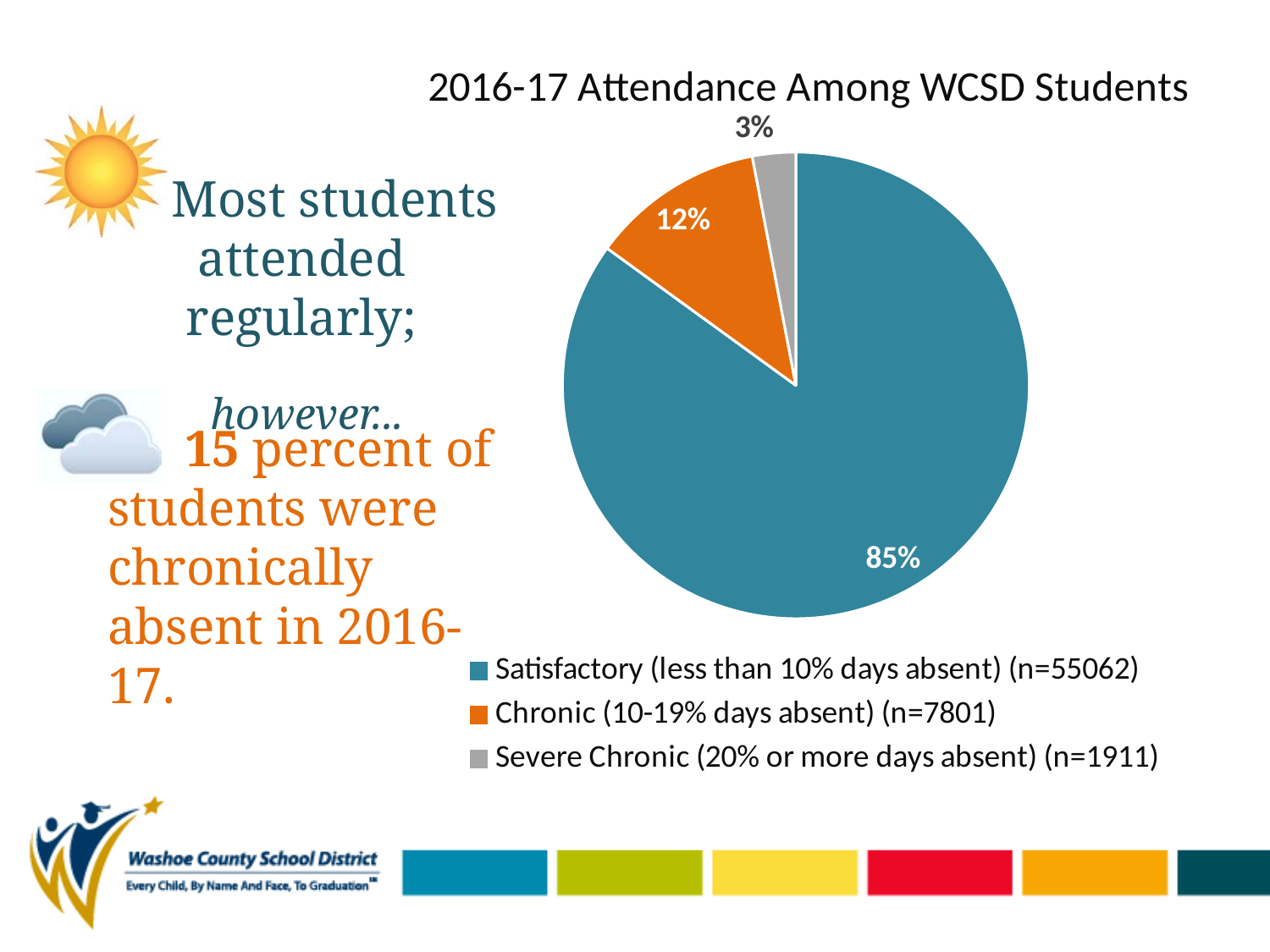
What percentage of students had Satisfactory attendance (less than 10% days absent)? 85% What percentage of students were Severe Chronic (20% or more days absent)? 3% What is the difference in percentage points between the Chronic and Severe Chronic slices? 9 What is the n value shown in the legend for the Chronic category? 7801 What is the combined percentage of the Chronic and Severe Chronic slices? 15% Which is larger, the Chronic slice or the Severe Chronic slice? Chronic Which category has the largest share of the pie? Satisfactory (less than 10% days absent) How many categories does the pie chart show? 3 What kind of chart is shown on the slide? pie chart What percentage of students were Chronic (10-19% days absent)? 12% Which category has the smallest share of the pie? Severe Chronic (20% or more days absent) What is the title of the chart? 2016-17 Attendance Among WCSD Students